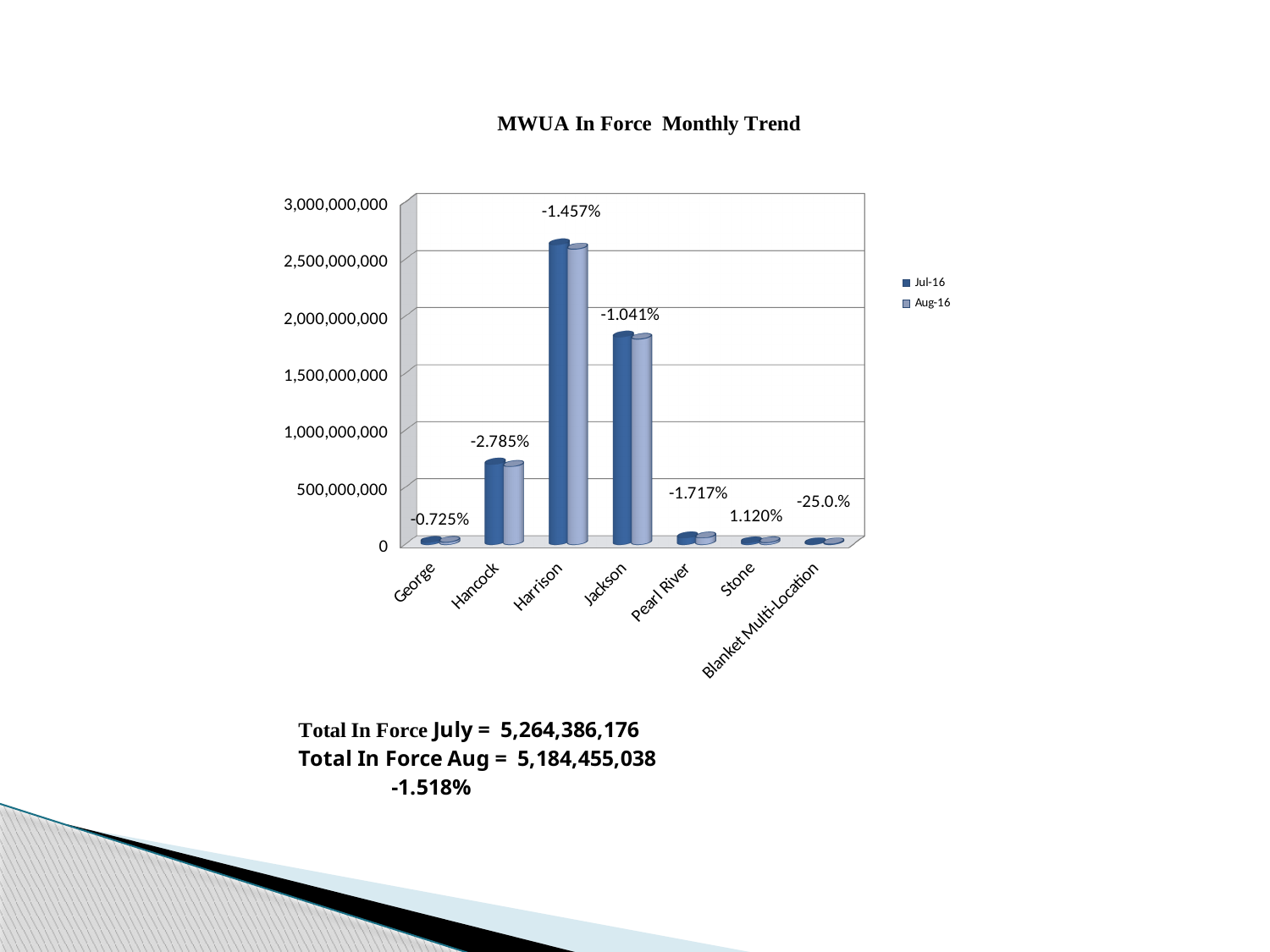
What percentage change is labelled above the Hancock bars? -2.785% What percentage change is labelled above the Harrison bars? -1.457% How many series does the legend list? 2 Is the Jul-16 value for Hancock greater or less than 500,000,000? greater What percentage change is labelled above the Blanket Multi-Location bars? -25.0.% What kind of chart is shown on the slide? bar chart What percentage change is labelled above the Stone bars? 1.120% How many categories are shown on the x axis? 7 What is the title of the chart? MWUA In Force Monthly Trend Which is larger, the Jul-16 value for Harrison or the Jul-16 value for Jackson? Harrison Which category has the highest in-force value? Harrison Is the Jul-16 value for Jackson greater or less than 2,000,000,000? less